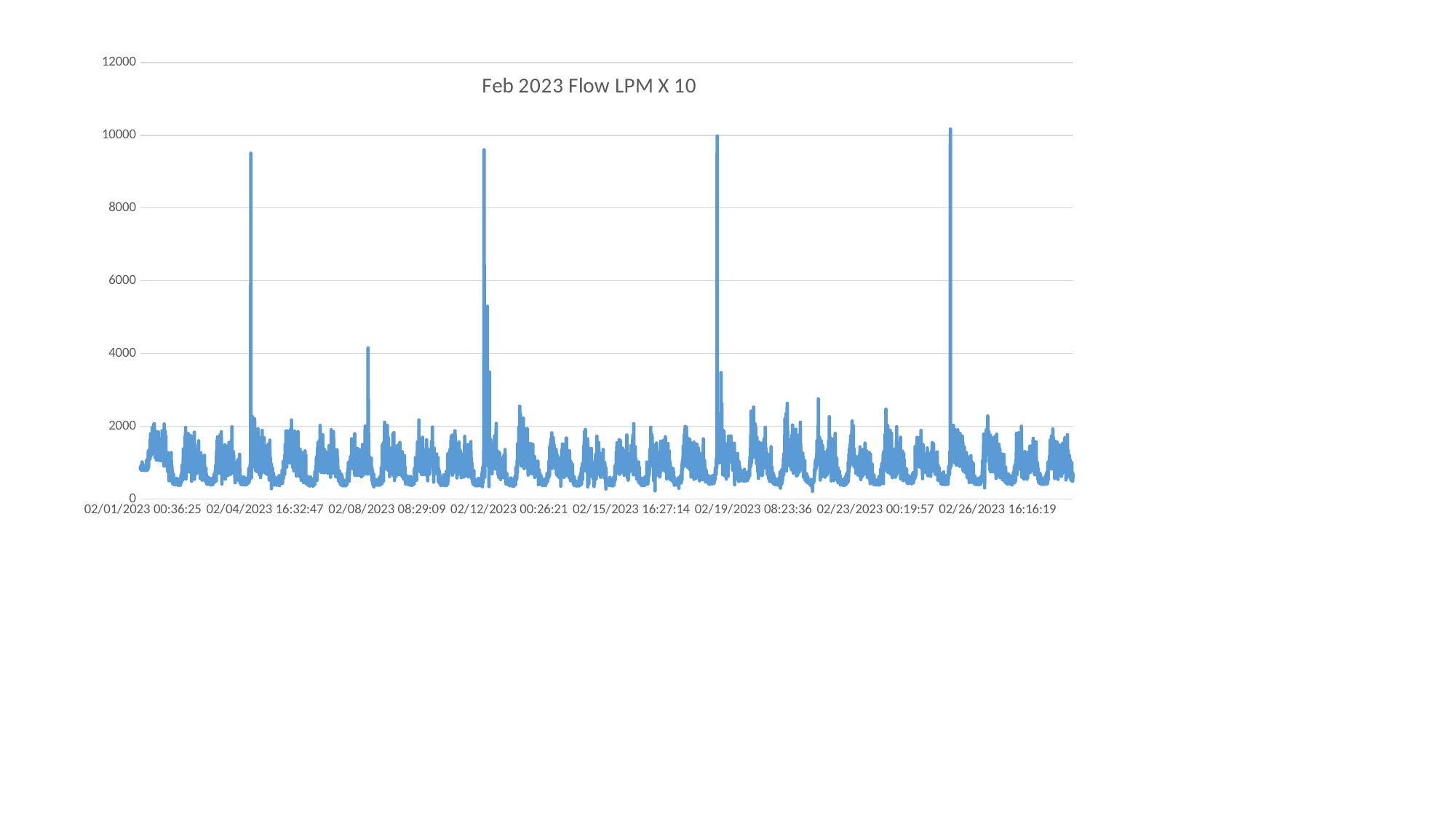
Is the spike near 02/08/2023 greater or less than 2000? greater What is the highest value shown on the vertical axis? 12000 Is the spike near 02/08/2023 greater or less than 6000? less What is the first date label shown on the horizontal axis? 02/01/2023 00:36:25 Is the tallest spike on the chart greater or less than 8000? greater Which is larger, the spike near 02/04/2023 or the spike near 02/08/2023? the spike near 02/04/2023 How many spikes on the chart rise above 8000? 4 What is the title of the chart? Feb 2023 Flow LPM X 10 What kind of chart is shown on the slide? line chart Which is larger, the spike near 02/26/2023 or the spike near 02/08/2023? the spike near 02/26/2023